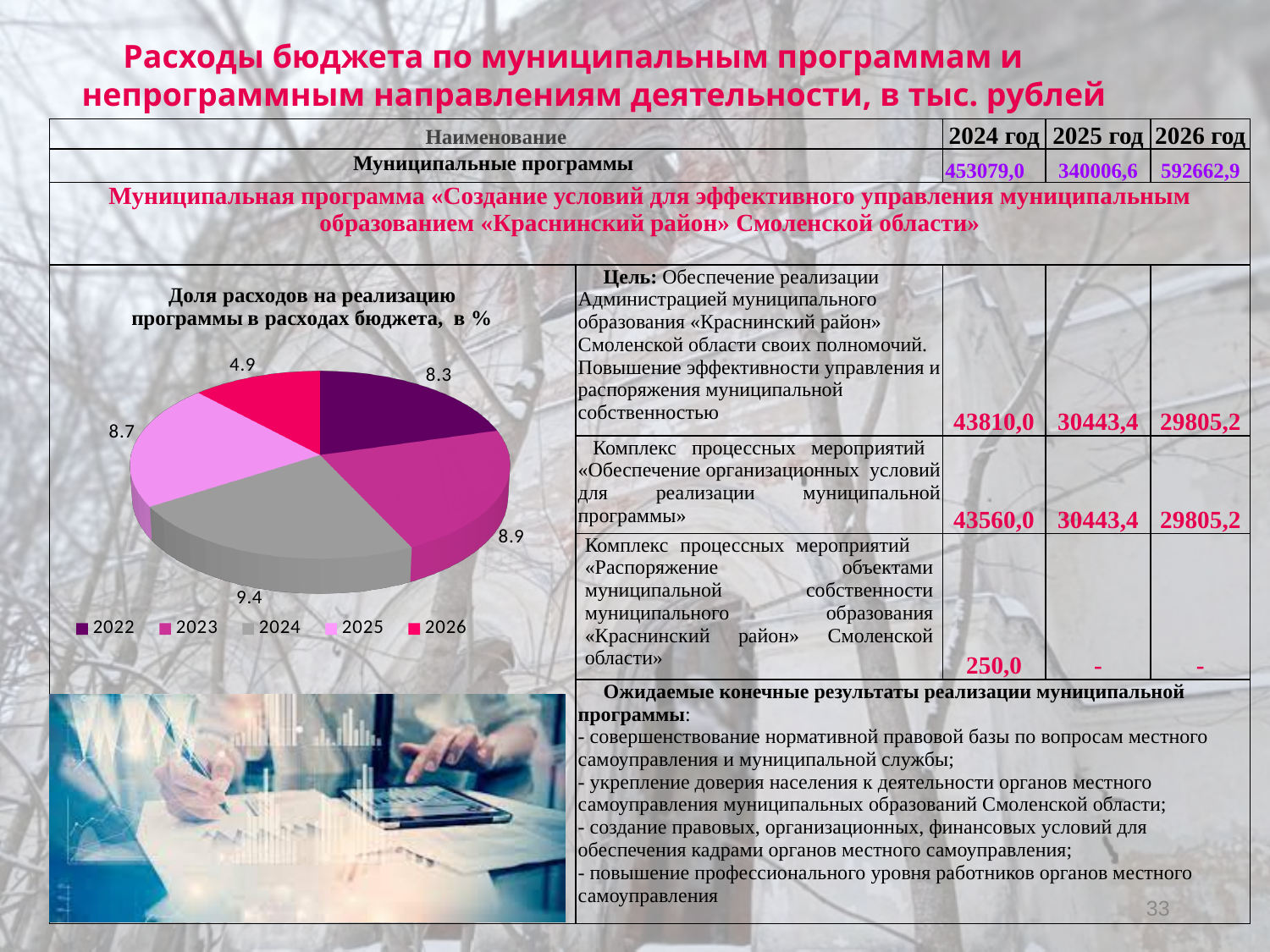
In the pie chart, what is the value for 2025? 8.7 In the pie chart, what is the value for 2022? 8.3 In the pie chart, which is larger: the value for 2023 or the value for 2022? 2023 In the pie chart, what is the value for 2026? 4.9 What is the difference between the values for 2024 and 2026 in the pie chart? 4.5 Which year has the smallest slice in the pie chart? 2026 Does the value in the pie chart rise or fall from 2024 to 2026? fall What type of chart is shown on the slide? pie chart In the pie chart, what is the value for 2024? 9.4 What is the title of the pie chart on the slide? Доля расходов на реализацию программы в расходах бюджета, в % How many slices does the pie chart have? 5 Which year has the largest slice in the pie chart? 2024